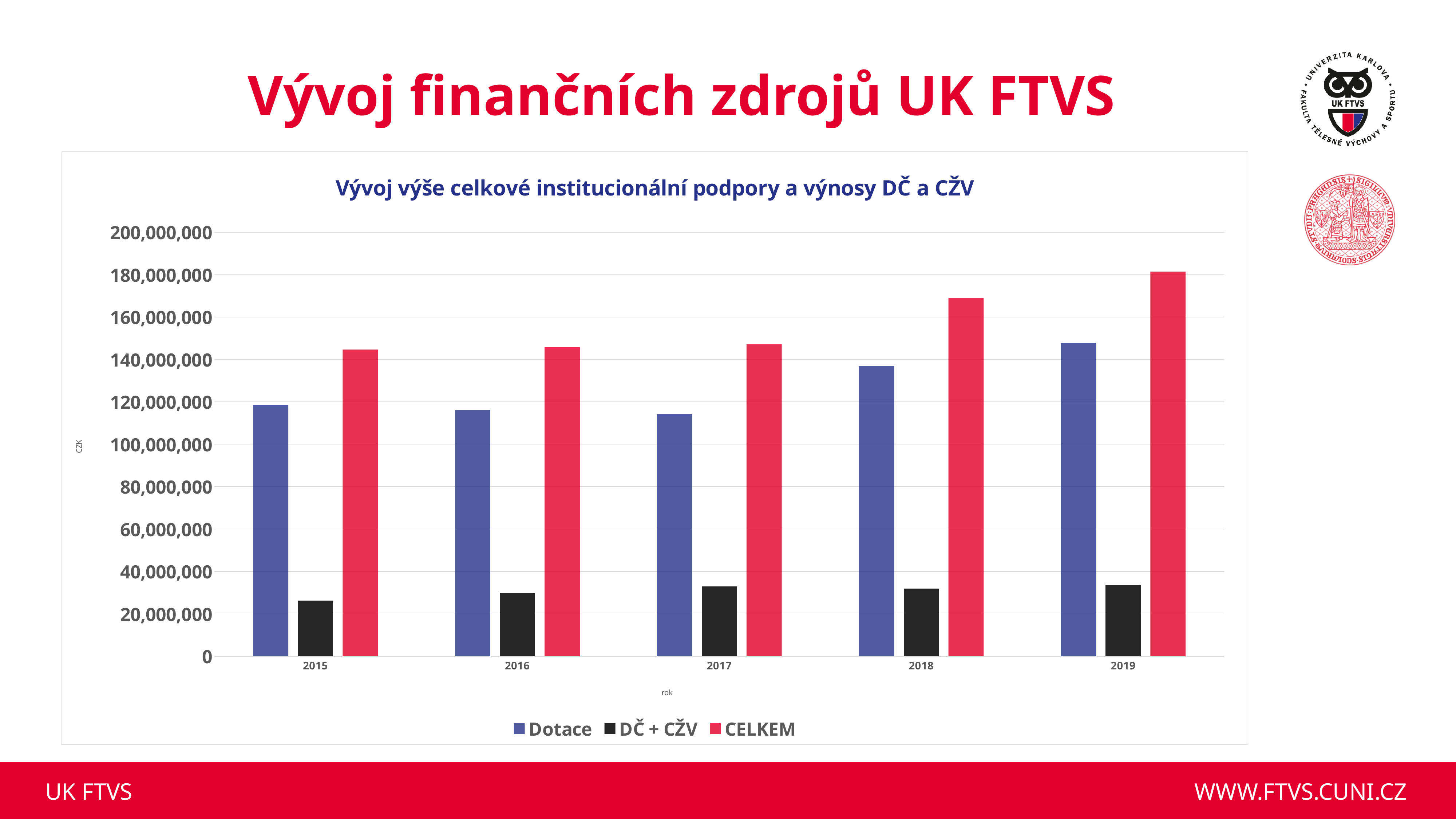
Is the DČ + CŽV value for 2015 greater or less than 40,000,000? less What kind of chart is shown on the slide? Bar chart Which is larger, the Dotace value for 2019 or the Dotace value for 2018? 2019 Do the CELKEM values rise or fall from 2015 to 2019? rise How many years are shown on the x axis? 5 Is the Dotace value for 2018 greater or less than 120,000,000? greater Is the CELKEM value for 2019 greater or less than 160,000,000? greater How many series does the legend list? 3 What is the title of the chart? Vývoj výše celkové institucionální podpory a výnosy DČ a CŽV In which year is the CELKEM value highest? 2019 In which year is the Dotace value highest? 2019 In which year is the DČ + CŽV value lowest? 2015